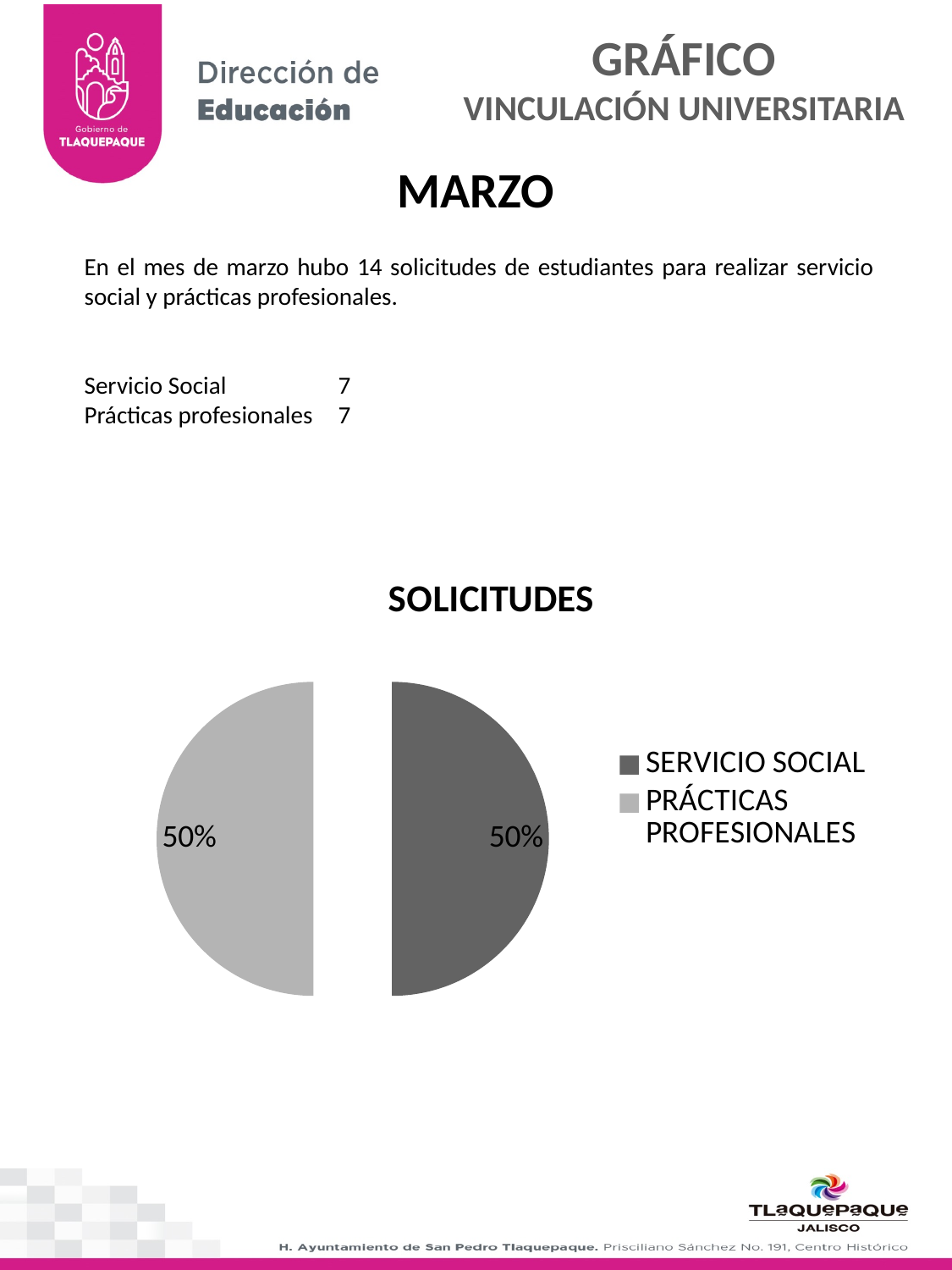
What share of the pie does PRÁCTICAS PROFESIONALES represent? 50% What kind of chart is shown under the title SOLICITUDES? pie chart Which legend entry is shown in the darker grey colour? SERVICIO SOCIAL What is the title of the chart? SOLICITUDES How many entries does the legend list? 2 What is the combined share of the two slices in the pie chart? 100% How many slices does the pie chart have? 2 What is the difference between the SERVICIO SOCIAL share and the PRÁCTICAS PROFESIONALES share? 0% What share of the pie does SERVICIO SOCIAL represent? 50%